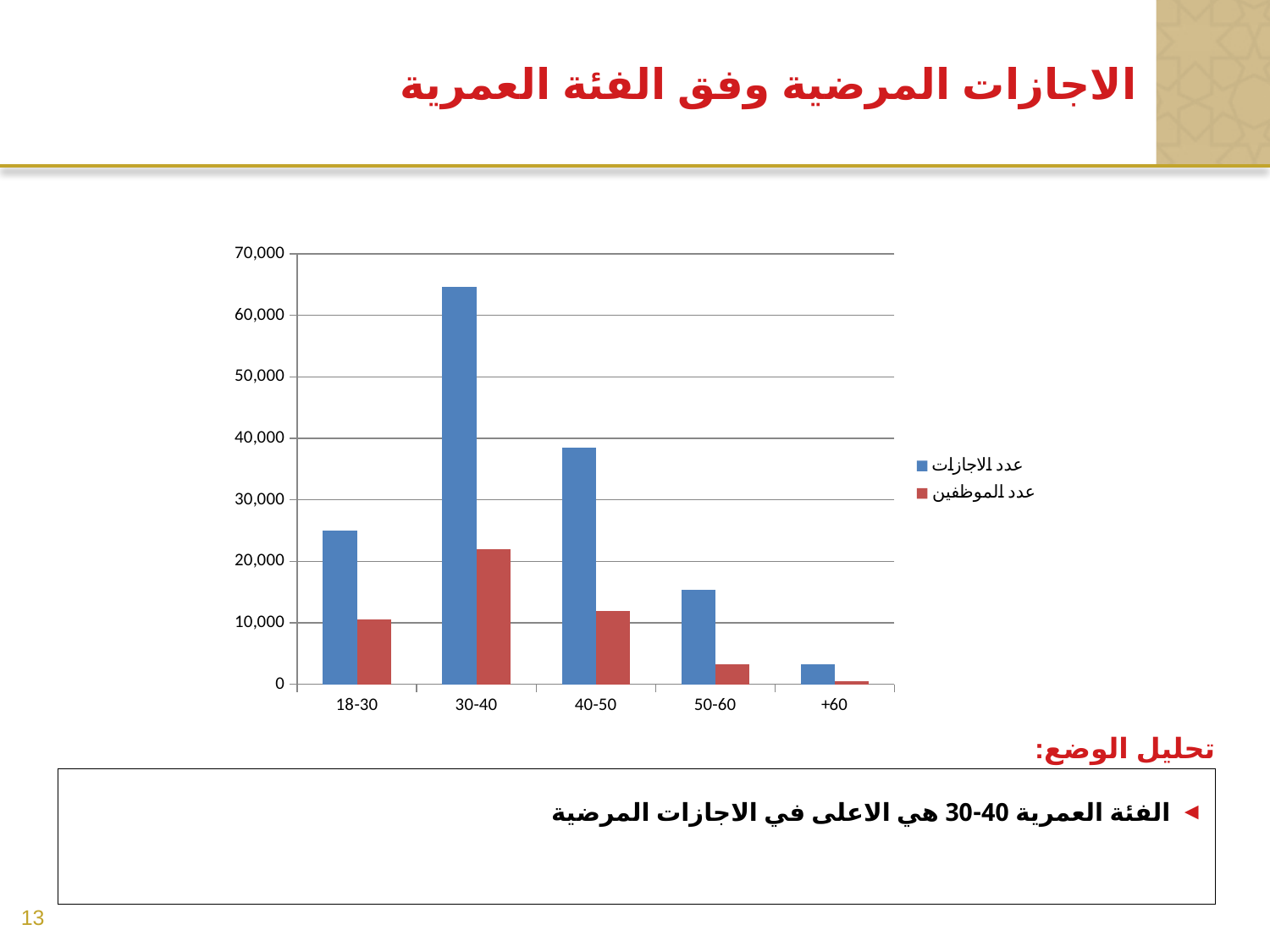
Which age category has the highest value for عدد الاجازات? 30-40 Is the value of عدد الاجازات for 18-30 greater or less than 20,000? greater Which age category has the lowest value for عدد الاجازات? +60 Which age category has the highest value for عدد الموظفين? 30-40 Which is larger, عدد الاجازات for 18-30 or عدد الاجازات for 40-50? 40-50 Is the value of عدد الاجازات for 30-40 greater or less than 60,000? greater What kind of chart is shown on the slide? bar chart Do the values of عدد الاجازات rise or fall from 30-40 to +60? fall Which series is shown in blue? عدد الاجازات How many series does the legend list? 2 How many age categories are shown on the x axis? 5 Is the value of عدد الاجازات for 50-60 greater or less than 20,000? less